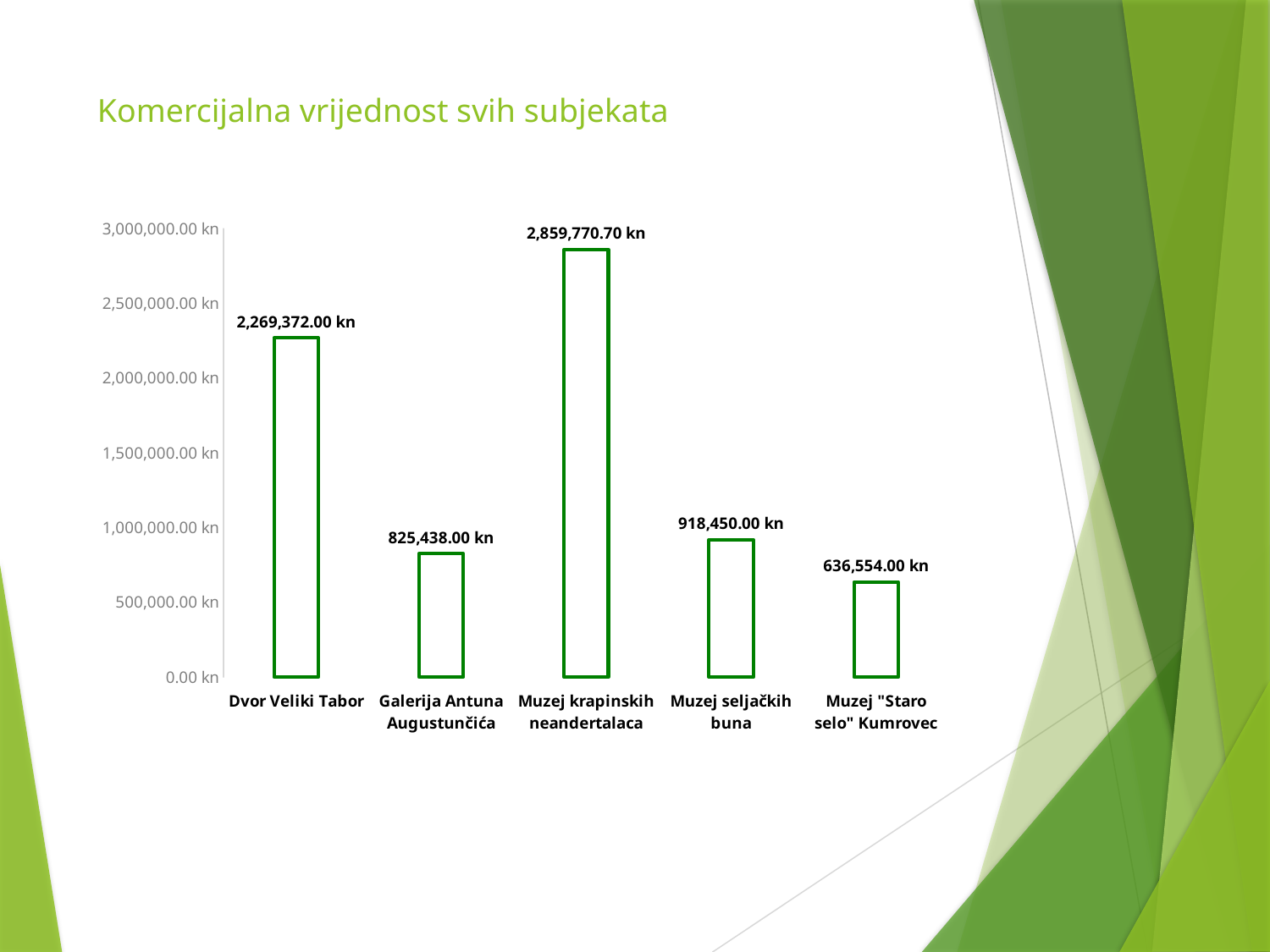
What kind of chart is shown on the slide? bar chart What is the value for Muzej "Staro selo" Kumrovec? 636,554.00 kn Is the value for Dvor Veliki Tabor greater or less than 2,000,000.00 kn? greater Which category has the highest value? Muzej krapinskih neandertalaca What is the value for Muzej krapinskih neandertalaca? 2,859,770.70 kn What is the difference between the values for Muzej krapinskih neandertalaca and Dvor Veliki Tabor? 590,398.70 kn What is the difference between the values for Muzej seljačkih buna and Galerija Antuna Augustunčića? 93,012.00 kn Which is larger, the value for Muzej seljačkih buna or the value for Galerija Antuna Augustunčića? Muzej seljačkih buna How many categories are shown on the x axis? 5 Which category has the lowest value? Muzej "Staro selo" Kumrovec What is the value for Dvor Veliki Tabor? 2,269,372.00 kn What is the value for Galerija Antuna Augustunčića? 825,438.00 kn